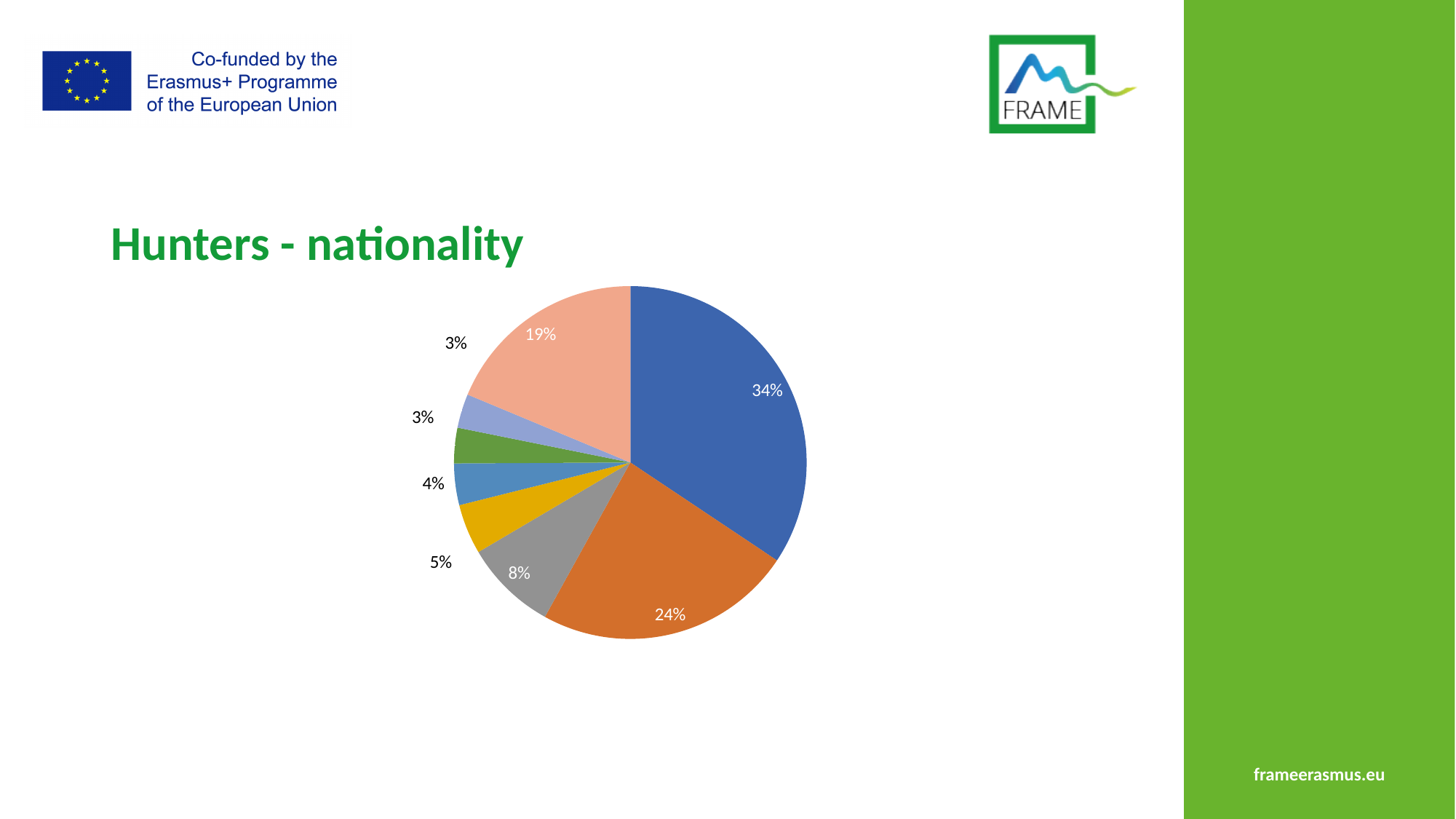
What percentage is shown on the grey slice of the pie chart? 8% What is the smallest percentage shown on any slice of the pie chart? 3% What kind of chart is shown on the slide? pie chart What percentage is shown on the orange slice of the pie chart? 24% How many slices does the pie chart have? 8 What is the difference in percentage points between the largest slice (34%) and the second largest slice (24%)? 10 percentage points What is the title of the chart on the slide? Hunters - nationality Which slice is larger, the orange slice or the salmon-coloured slice? the orange slice What is the combined share of the two largest slices (34% and 24%)? 58% What is the percentage of the largest slice in the pie chart? 34% What percentage is shown on the light salmon (peach) slice of the pie chart? 19% What percentage is shown on the dark blue slice of the pie chart? 34%